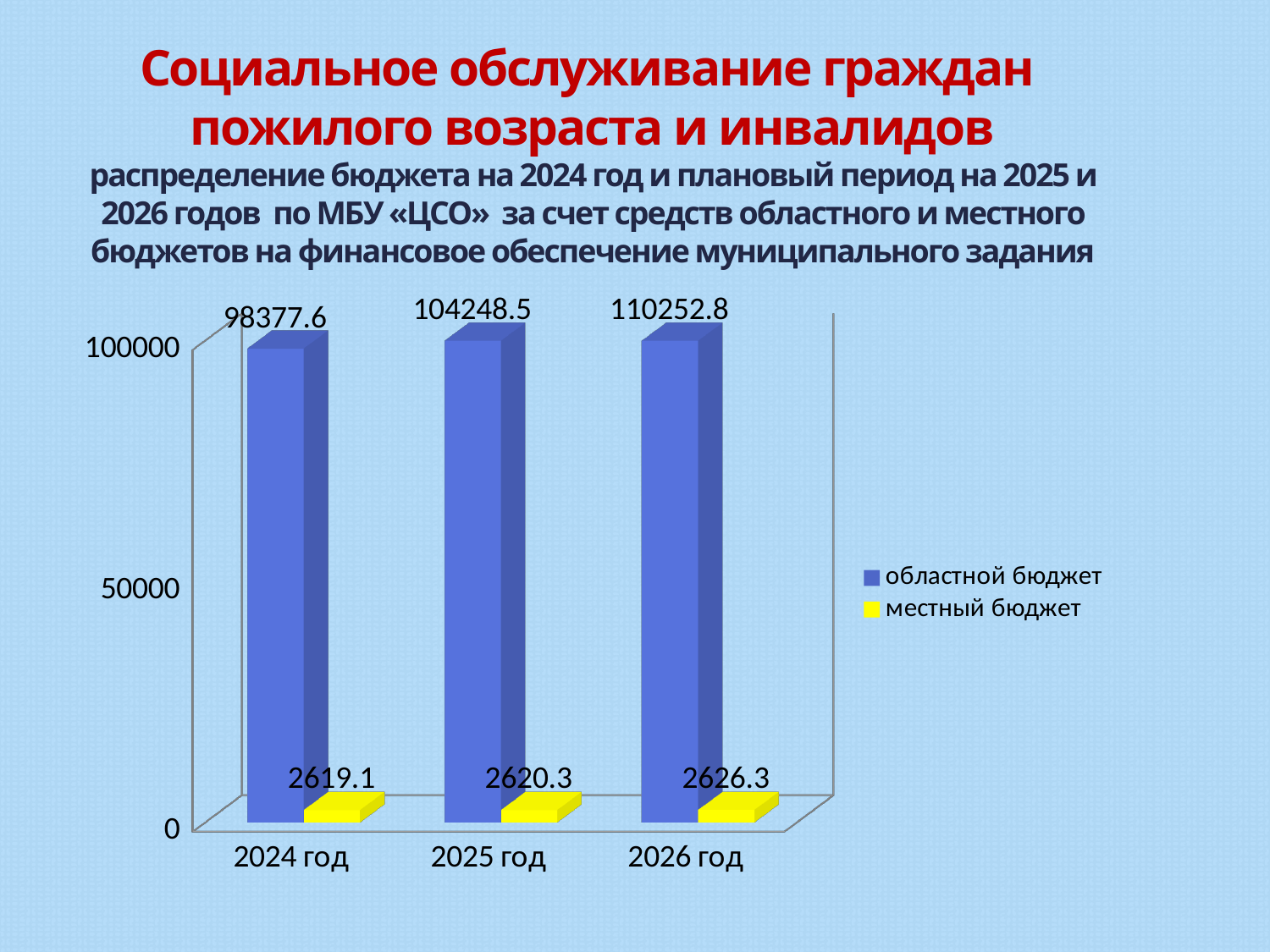
What is the difference between the областной бюджет values for 2025 год and 2024 год? 5870.9 Do the областной бюджет values rise or fall from 2024 год to 2026 год? rise What is the difference between the областной бюджет values for 2026 год and 2024 год? 11875.2 What is the value for местный бюджет in 2025 год? 2620.3 Which year has the highest value for областной бюджет? 2026 год What is the value for областной бюджет in 2025 год? 104248.5 How many series does the legend list? 2 What kind of chart is shown on the slide? bar chart What is the value for местный бюджет in 2026 год? 2626.3 Which is larger in 2024 год: областной бюджет or местный бюджет? областной бюджет What is the value for областной бюджет in 2024 год? 98377.6 Which year has the lowest value for областной бюджет? 2024 год